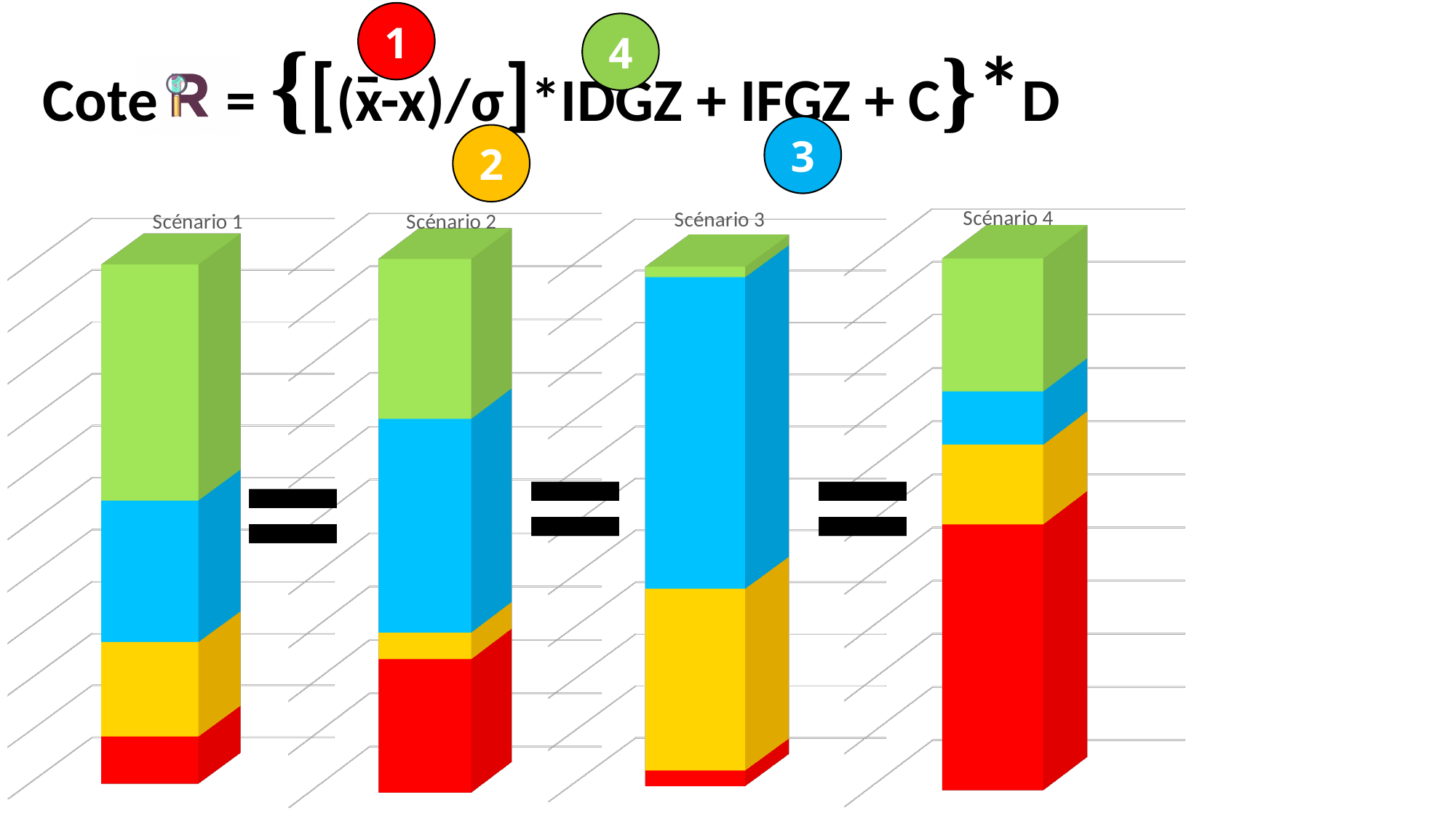
In the Scénario 2 chart, which colour segment is the smallest? Yellow In the Scénario 1 chart, which colour segment is the largest? Green What kind of chart is used for Scénario 1? Stacked bar chart How many scenario charts are shown on the slide? 4 In the Scénario 3 chart, which colour segment is the largest? Blue In the Scénario 3 chart, is the blue segment or the yellow segment larger? Blue What is the title of the leftmost chart on the slide? Scénario 1 In the Scénario 2 chart, which colour segment is the largest? Blue How many coloured segments make up the bar in the Scénario 1 chart? 4 In the Scénario 1 chart, which colour segment is the smallest? Red In the Scénario 4 chart, is the green segment or the blue segment larger? Green